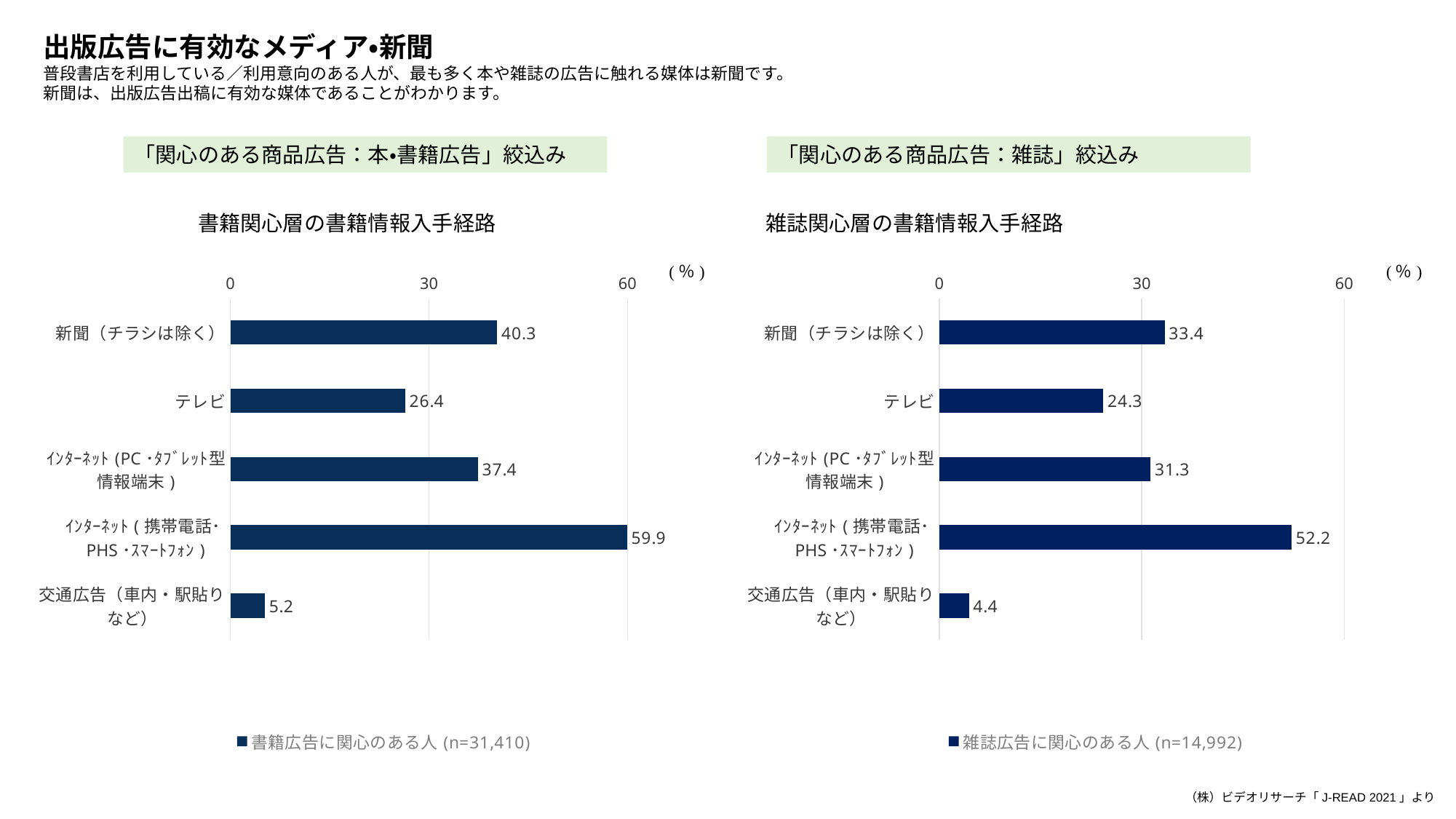
In the right chart (雑誌関心層の書籍情報入手経路), which category has the lowest value? 交通広告（車内・駅貼りなど） What is the legend entry of the right chart (雑誌関心層の書籍情報入手経路)? 雑誌広告に関心のある人 (n=14,992) How many series does the legend of the right chart (雑誌関心層の書籍情報入手経路) list? 1 In the right chart (雑誌関心層の書籍情報入手経路), which is larger: 新聞（チラシは除く） or インターネット（PC・タブレット型情報端末）? 新聞（チラシは除く） In the left chart (書籍関心層の書籍情報入手経路), is the value for テレビ greater or less than 30? less In the left chart (書籍関心層の書籍情報入手経路), what is the value for 新聞（チラシは除く）? 40.3 In the right chart (雑誌関心層の書籍情報入手経路), what is the difference between the values for インターネット（携帯電話・PHS・スマートフォン） and 新聞（チラシは除く）? 18.8 How many categories are shown in the left chart (書籍関心層の書籍情報入手経路)? 5 What kind of chart is the left chart (書籍関心層の書籍情報入手経路)? Bar chart In the left chart (書籍関心層の書籍情報入手経路), which category has the highest value? インターネット（携帯電話・PHS・スマートフォン） In the right chart (雑誌関心層の書籍情報入手経路), what is the value for テレビ? 24.3 In the left chart (書籍関心層の書籍情報入手経路), what is the difference between the values for 新聞（チラシは除く） and テレビ? 13.9